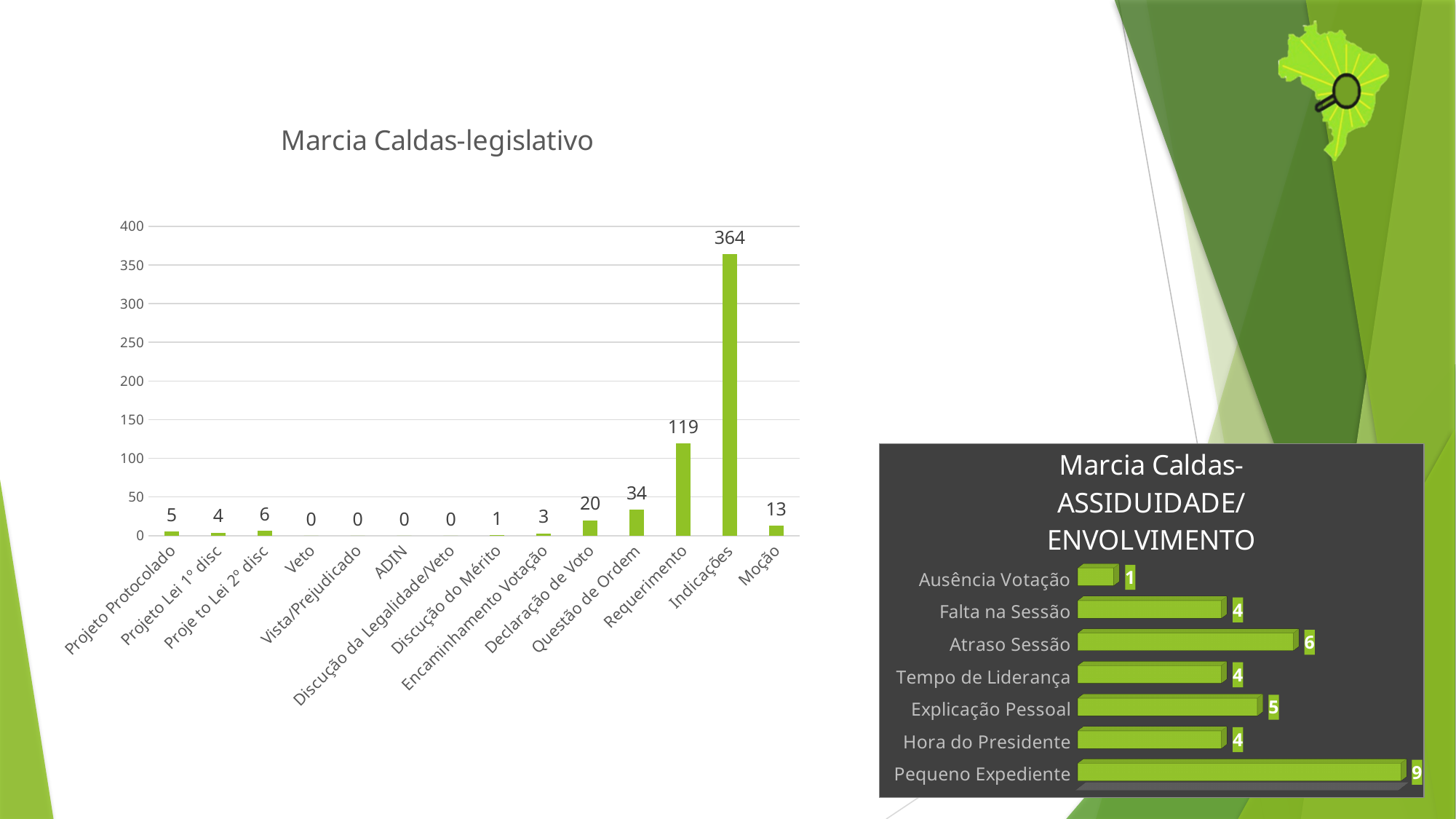
In the 'Marcia Caldas-ASSIDUIDADE/ENVOLVIMENTO' chart, which category has the lowest value? Ausência Votação What kind of chart is 'Marcia Caldas-legislativo'? Bar chart In the 'Marcia Caldas-legislativo' chart, what is the value for Indicações? 364 In the 'Marcia Caldas-ASSIDUIDADE/ENVOLVIMENTO' chart, what is the value for Pequeno Expediente? 9 In the 'Marcia Caldas-legislativo' chart, what is the value for Requerimento? 119 In the 'Marcia Caldas-legislativo' chart, which is larger, Questão de Ordem or Declaração de Voto? Questão de Ordem In the 'Marcia Caldas-legislativo' chart, what is the difference between Indicações and Requerimento? 245 In the 'Marcia Caldas-legislativo' chart, how many categories are shown on the x axis? 14 In the 'Marcia Caldas-ASSIDUIDADE/ENVOLVIMENTO' chart, how many categories are shown? 7 In the 'Marcia Caldas-legislativo' chart, what is the value for Moção? 13 In the 'Marcia Caldas-legislativo' chart, which category has the highest value? Indicações In the 'Marcia Caldas-ASSIDUIDADE/ENVOLVIMENTO' chart, what is the difference between Atraso Sessão and Falta na Sessão? 2